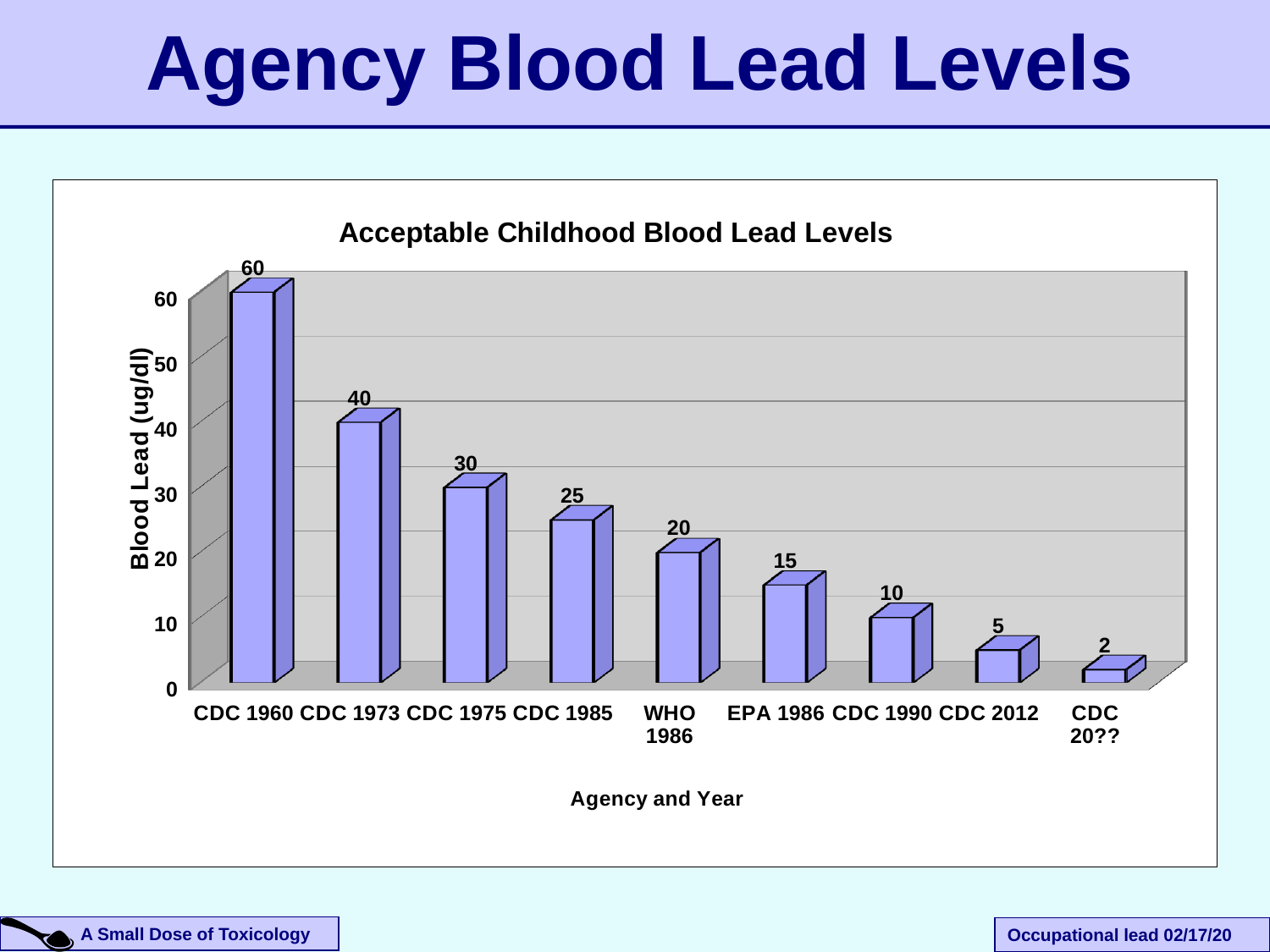
Which category has the highest blood lead level? CDC 1960 What is the title of the chart? Acceptable Childhood Blood Lead Levels What is the difference between the values for CDC 1973 and CDC 1985? 15 Which category has the lowest blood lead level? CDC 20?? How many categories are shown on the x axis? 9 What kind of chart is this? Bar chart What value is shown for CDC 2012? 5 What is the acceptable childhood blood lead level shown for CDC 1960? 60 What value is shown for WHO 1986? 20 Which is larger, the value for EPA 1986 or the value for CDC 1990? EPA 1986 Do the values rise or fall from left to right along the x axis? Fall Is the value for CDC 1975 greater or less than 20? greater